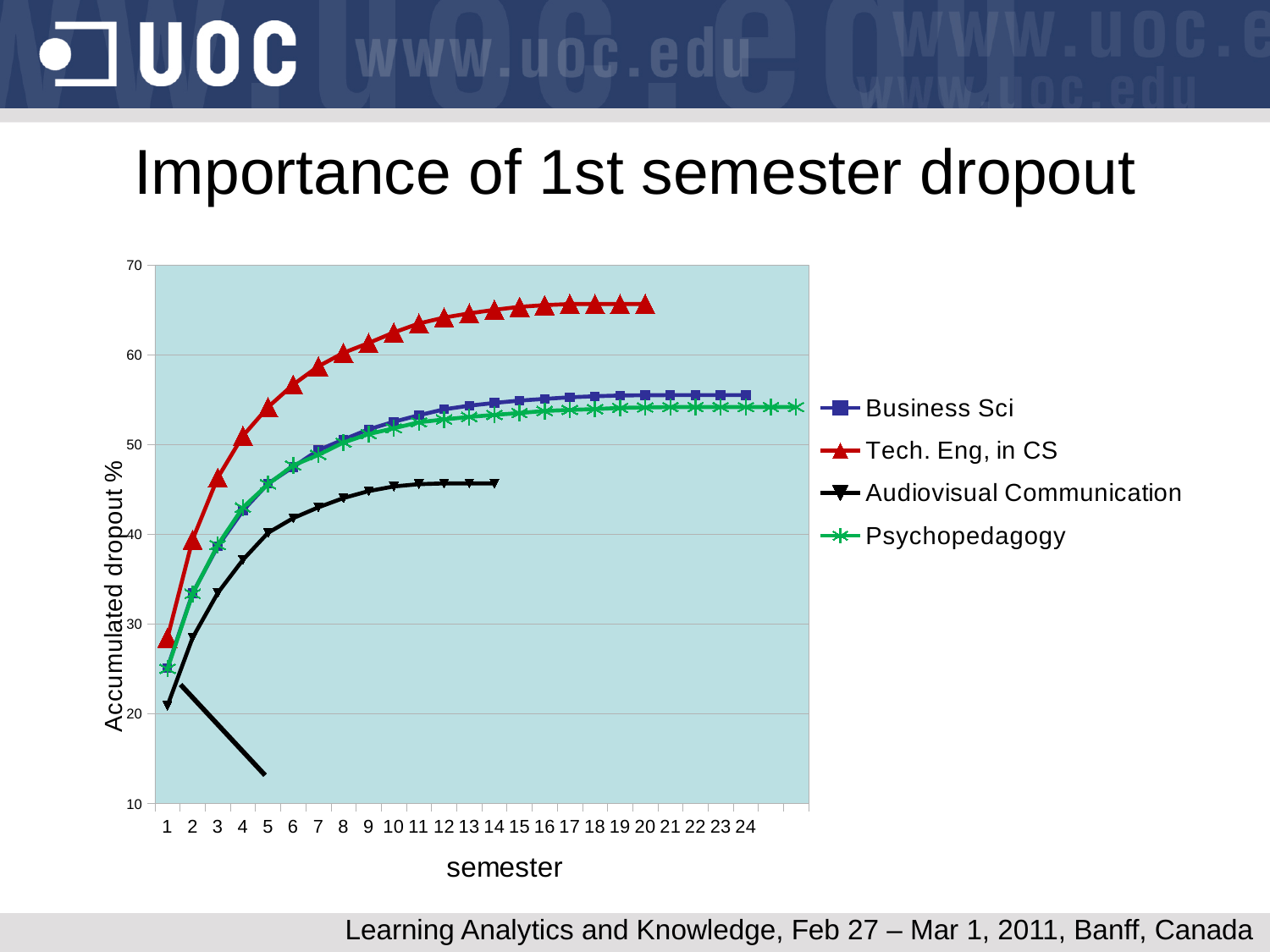
At semester 10, which is larger: Tech. Eng, in CS or Audiovisual Communication? Tech. Eng, in CS Is the value for Business Sci at semester 24 greater or less than 50? greater Do the accumulated dropout values rise or fall as the semester number increases? rise Which series reaches the highest accumulated dropout %? Tech. Eng, in CS Is the value for Tech. Eng, in CS at semester 20 greater or less than 60? greater Which series has the lowest accumulated dropout % at semester 1? Audiovisual Communication Is the value for Audiovisual Communication at semester 14 greater or less than 50? less How many series does the legend list? 4 What is the label of the y axis? Accumulated dropout % What kind of chart is shown on the slide? line chart How many semesters are shown on the x axis? 24